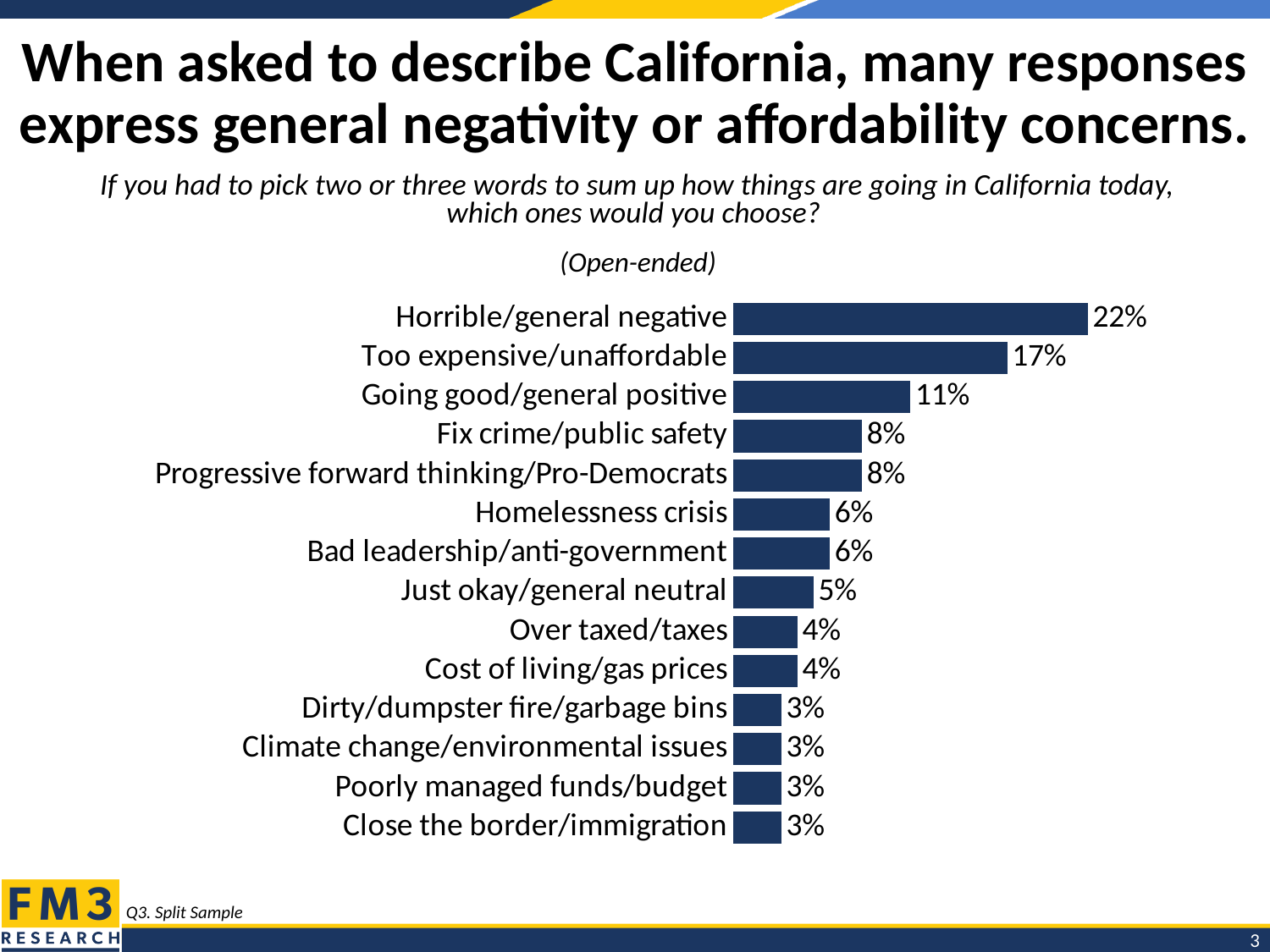
What is the survey question shown above the chart? If you had to pick two or three words to sum up how things are going in California today, which ones would you choose? What is the value for 'Homelessness crisis'? 6% Which category has the highest value? Horrible/general negative What value is shown for 'Close the border/immigration'? 3% What kind of chart is shown on the slide? Bar chart How many categories are shown in the chart? 14 What percentage of responses were 'Horrible/general negative'? 22% Which is larger, 'Fix crime/public safety' or 'Over taxed/taxes'? Fix crime/public safety What percentage of responses were 'Too expensive/unaffordable'? 17% What is the value for 'Going good/general positive'? 11% What is the difference between 'Horrible/general negative' and 'Too expensive/unaffordable'? 5% What is the difference between 'Going good/general positive' and 'Just okay/general neutral'? 6%